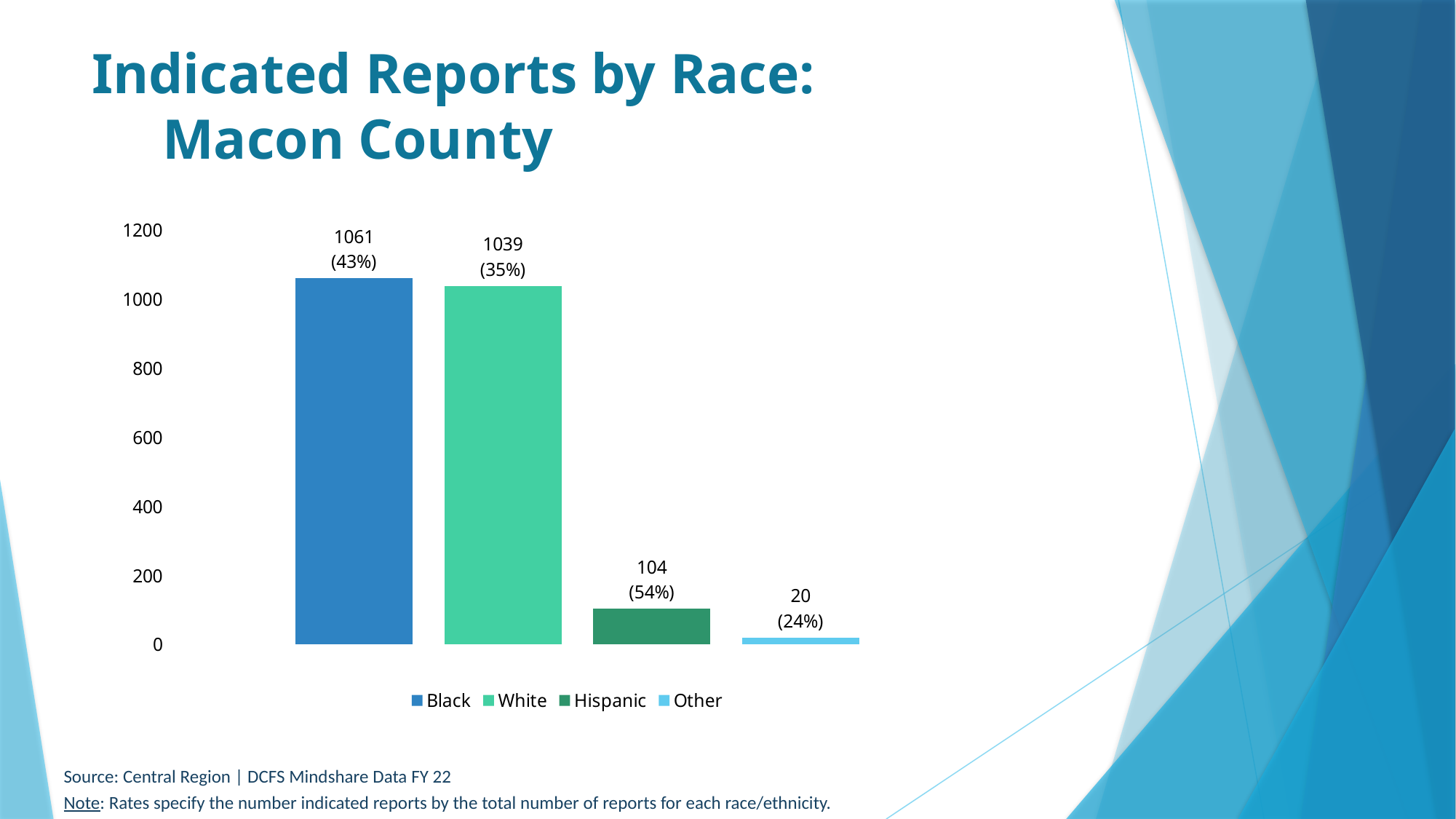
What percentage is shown for Other? 24% What is the number of indicated reports for Black? 1061 Which has more indicated reports, Hispanic or Other? Hispanic What is the number of indicated reports for Hispanic? 104 What kind of chart is shown on the slide? Bar chart What is the number of indicated reports for White? 1039 What is the title of the slide? Indicated Reports by Race: Macon County Which race has the lowest number of indicated reports? Other Is the value for White greater or less than 1000? greater How many race categories are shown in the chart? 4 Which race has the highest number of indicated reports? Black What is the difference between the number of indicated reports for Black and White? 22